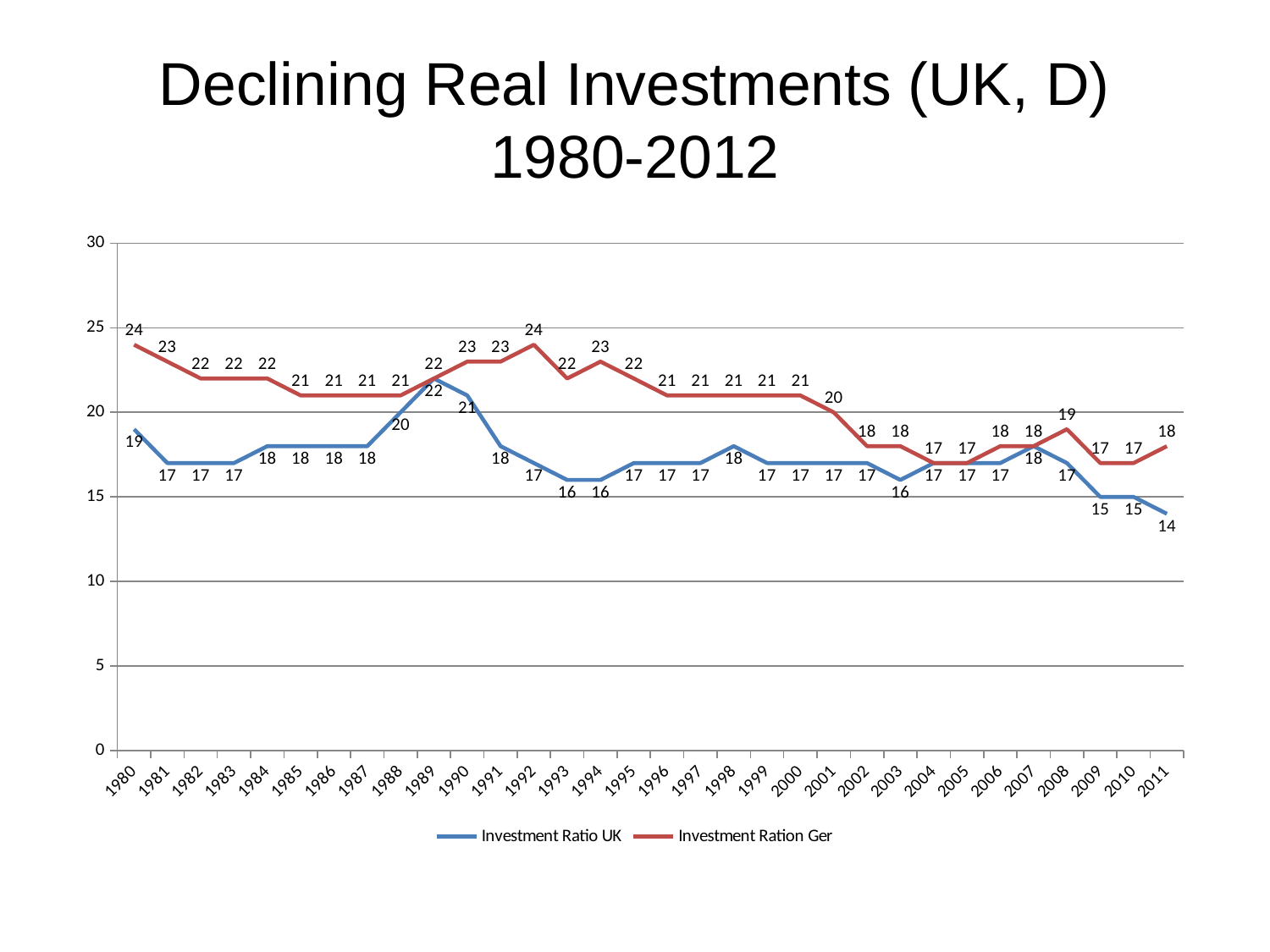
What is the title of the chart? Declining Real Investments (UK, D) 1980-2012 What is the Investment Ratio UK value for 2011? 14 How many series does the legend list? 2 In which year does the Investment Ratio UK series reach its lowest value? 2011 What is the Investment Ration Ger value for 1992? 24 Overall, does the Investment Ratio UK series rise or fall from 1980 to 2011? fall What type of chart is shown on the slide? line chart What is the Investment Ration Ger value for 2001? 20 Is the Investment Ration Ger value for 1980 greater or less than 20? greater What is the Investment Ratio UK value for 1980? 19 What is the difference between the Investment Ration Ger and Investment Ratio UK values in 1980? 5 Which series has the higher value in 1989, Investment Ratio UK or Investment Ration Ger? Neither; both are 22